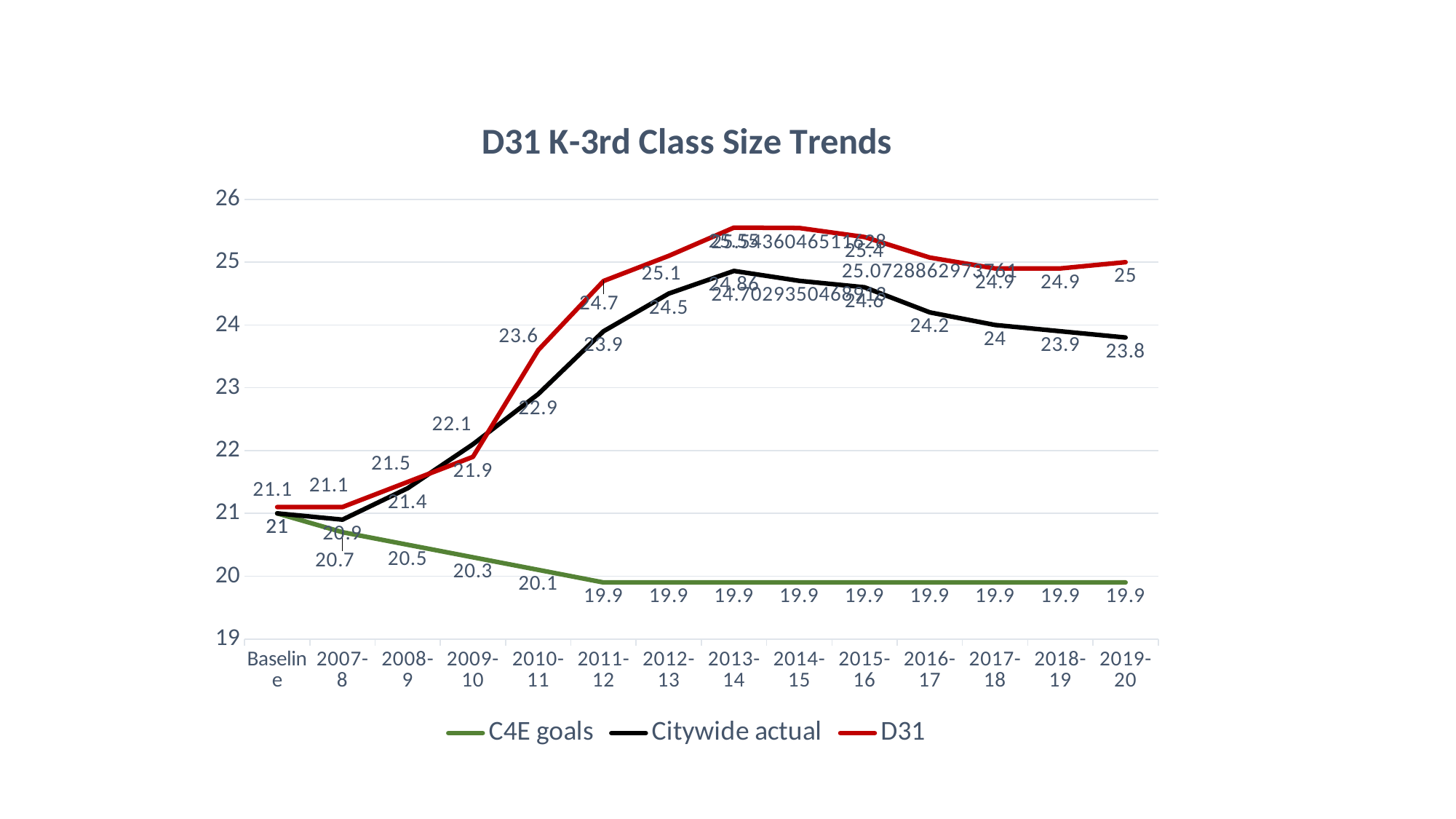
What kind of chart is shown on the slide? line chart How many series does the legend list? 3 Do the C4E goals values rise or fall from Baseline to 2011-12? fall In 2010-11, which is larger: the D31 value or the Citywide actual value? D31 What is the D31 value for 2019-20? 25 What is the Citywide actual value for 2019-20? 23.8 What colour is the D31 line? red How many categories are shown along the x axis? 14 Is the D31 value for 2013-14 greater or less than 25? greater What is the C4E goals value for 2010-11? 20.1 For which category is the C4E goals value highest? Baseline What is the difference between the D31 and Citywide actual values in 2012-13? 0.6